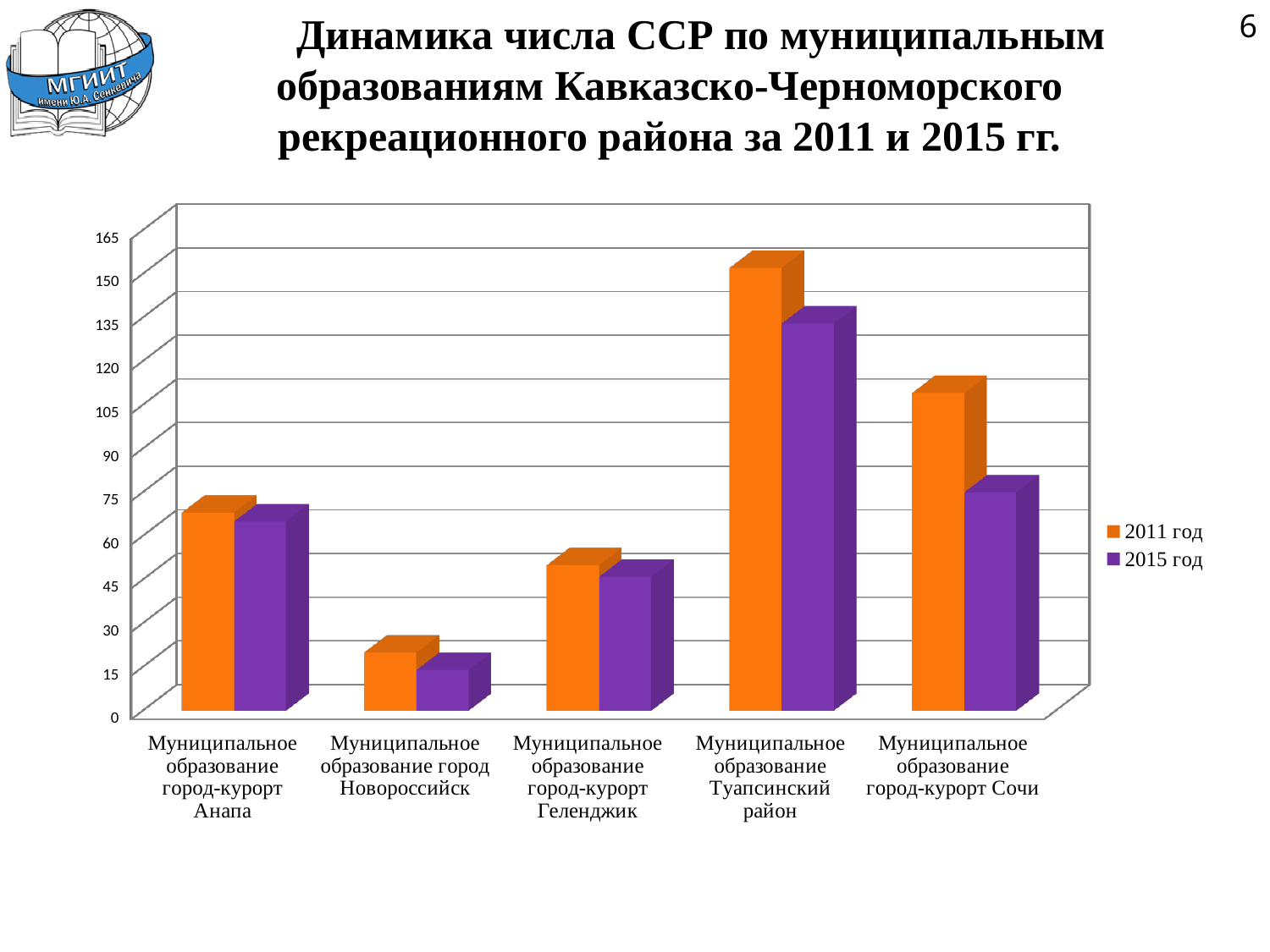
Which colour represents the 2015 год series in the legend? Purple How many series does the legend list? 2 Is the 2015 год value for Муниципальное образование город-курорт Геленджик greater or less than 60? less How many municipal entities (categories) are shown on the x axis? 5 Is the 2011 год value for Муниципальное образование город-курорт Сочи greater or less than 90? greater Which is larger for Муниципальное образование город-курорт Сочи: the 2011 год value or the 2015 год value? 2011 год What kind of chart is shown on the slide? Bar chart Which municipal entity has the highest value for 2011 год? Муниципальное образование Туапсинский район Which has the larger 2011 год value: Муниципальное образование Туапсинский район or Муниципальное образование город-курорт Сочи? Муниципальное образование Туапсинский район Which municipal entity has the lowest value for 2015 год? Муниципальное образование город Новороссийск Is the 2011 год value for Муниципальное образование Туапсинский район greater or less than 135? greater